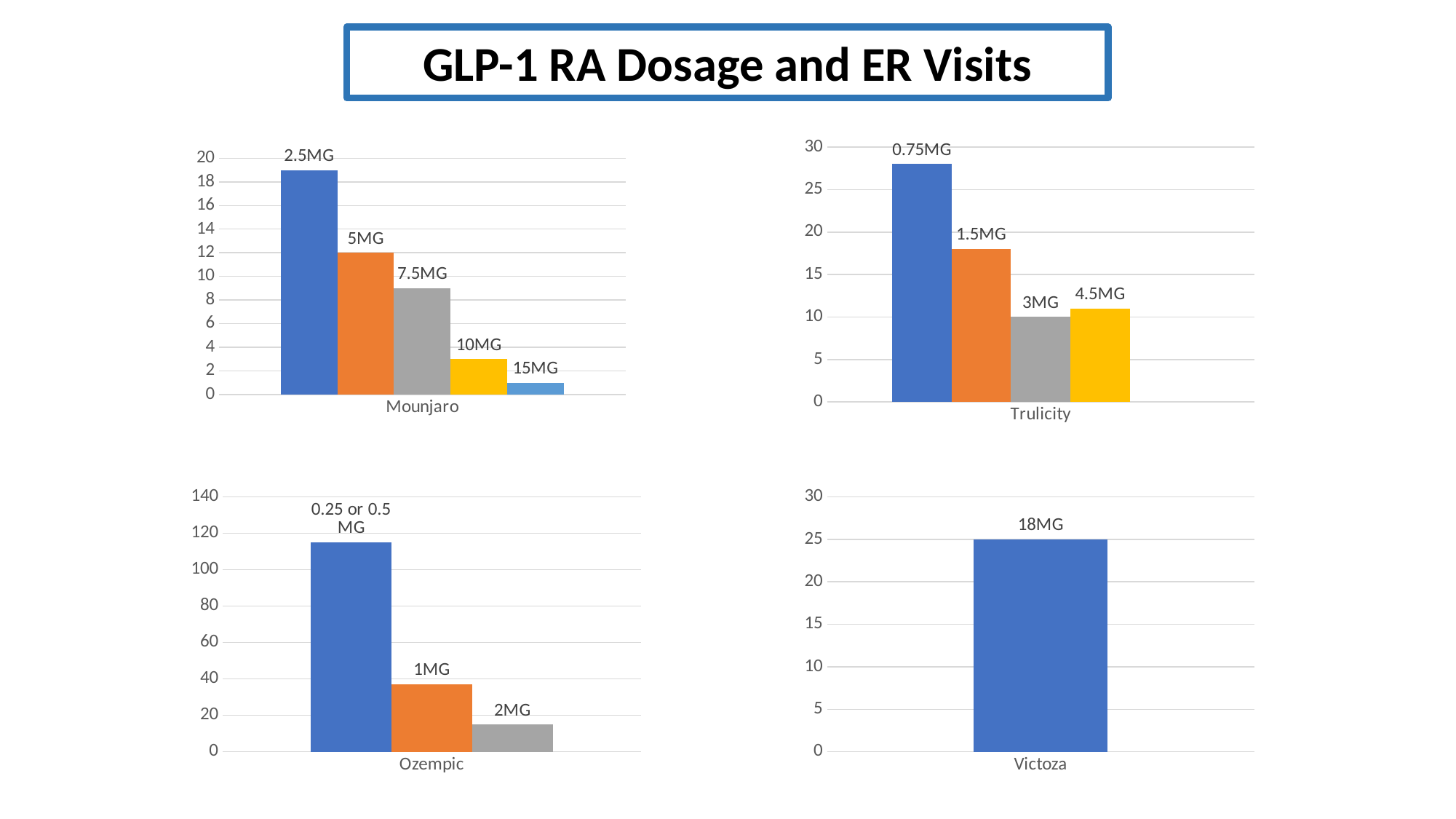
What kind of chart is the Victoza chart? bar chart On the Mounjaro chart, which dosage has the lowest bar? 15MG On the Mounjaro chart, which dosage has the highest bar? 2.5MG On the Victoza chart, what is the value for the 18MG bar? 25 On the Trulicity chart, what is the value for the 3MG bar? 10 On the Trulicity chart, which dosage has the highest bar? 0.75MG On the Trulicity chart, is the value for the 0.75MG bar greater or less than 25? greater On the Mounjaro chart, how many bars are plotted? 5 On the Ozempic chart, do the values rise or fall as the dosage increases from left to right? fall On the Ozempic chart, which dosage has the lowest bar? 2MG On the Ozempic chart, is the value for the 0.25 or 0.5 MG bar greater or less than 100? greater On the Mounjaro chart, what is the value for the 5MG bar? 12